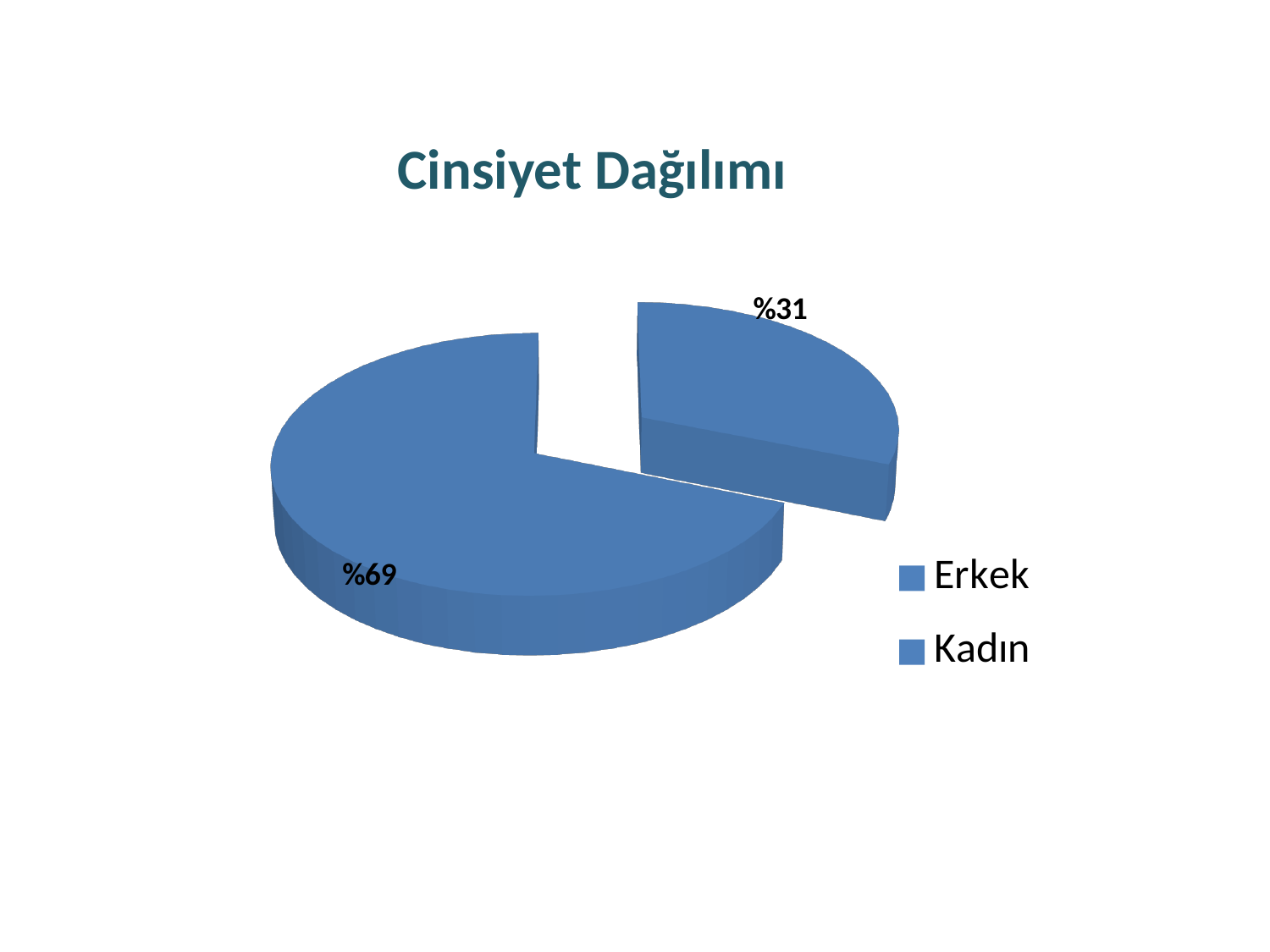
How many slices does the pie chart have? 2 What percentage is shown on the smallest slice of the pie? %31 What percentage is shown on the largest slice of the pie? %69 What is the title of the chart? Cinsiyet Dağılımı Is the larger slice of the pie greater or less than 50%? greater What kind of chart is shown on the slide? pie chart What is the difference in percentage points between the two slices of the pie? 38 What are the two entries listed in the legend? Erkek and Kadın What do the two slice percentages add up to? 100 How many entries does the legend list? 2 Which slice is larger, the one labelled %69 or the one labelled %31? %69